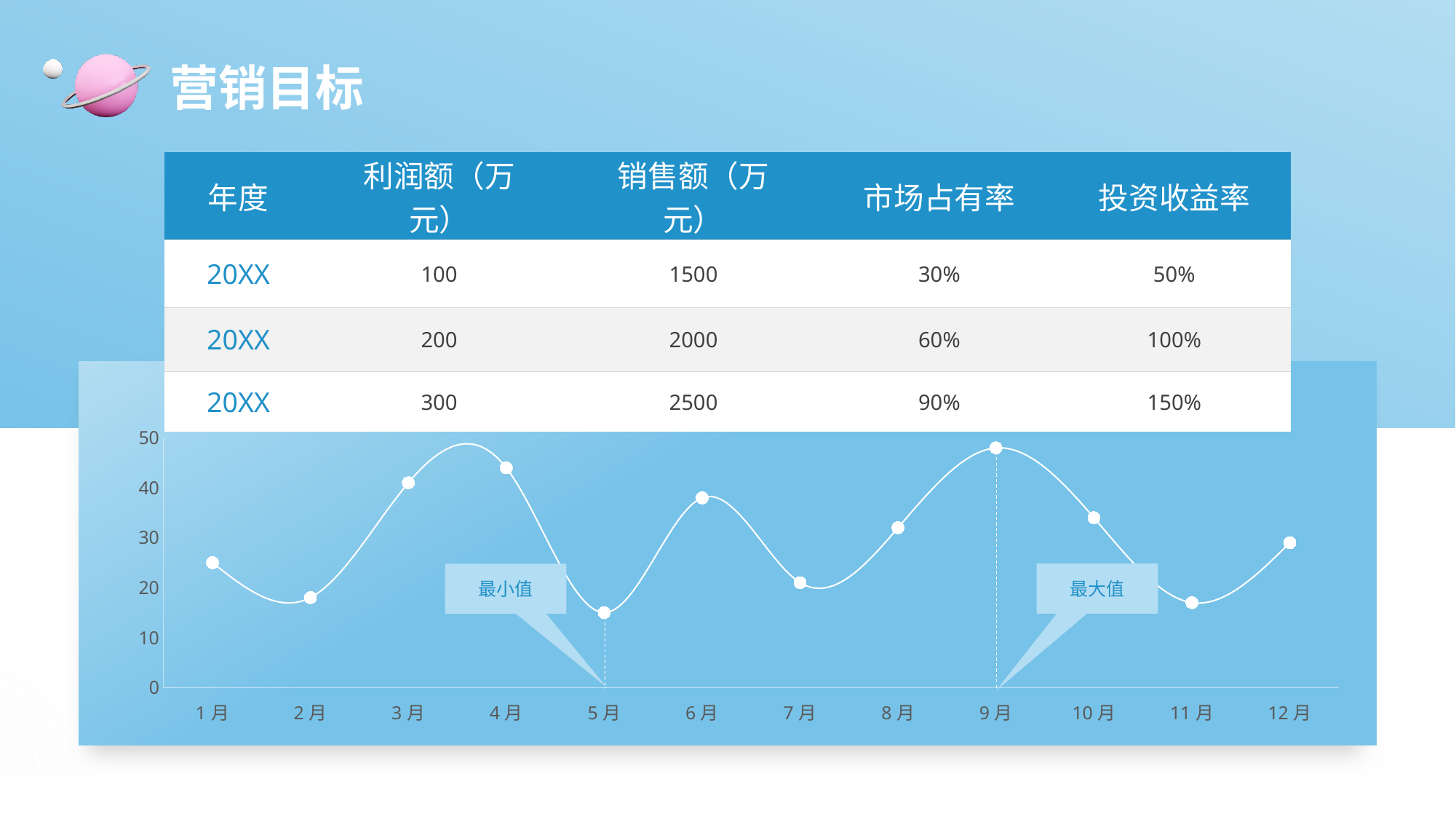
Which is larger in the line chart, the value for 3月 or the value for 2月? 3月 How many months are plotted on the x axis of the line chart? 12 Which month has the lowest value in the line chart? 5月 Which is larger in the line chart, the value for 6月 or the value for 7月? 6月 Does the line rise or fall from 2月 to 4月? rise Is the value for 9月 greater or less than 40? greater Is the value for 4月 greater or less than 40? greater Is the value for 5月 greater or less than 20? less What kind of chart is shown at the bottom of the slide? line chart Which month has the highest value in the line chart? 9月 What label does the callout attached to the 9月 point show? 最大值